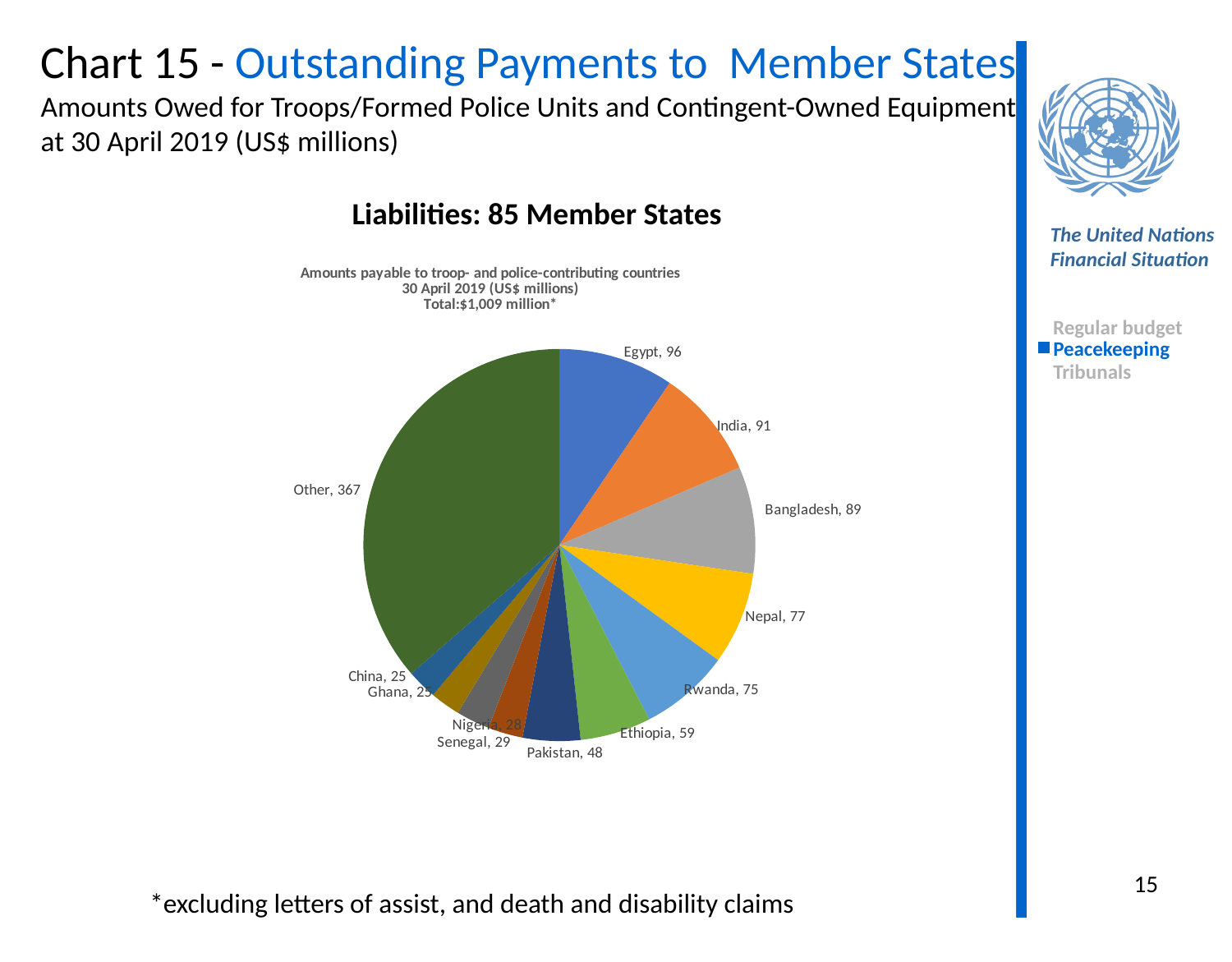
Which slice of the pie chart is the largest? Other What is the value for Senegal in the pie chart? 29 Which is larger, the value for Nepal or the value for Ethiopia? Nepal Which named country has the highest amount payable in the pie chart? Egypt What is the value for Bangladesh in the pie chart? 89 What is the difference between the values for Other and Ethiopia? 308 What is the value for Egypt in the pie chart? 96 What type of chart is shown on the slide? pie chart What total amount is stated in the pie chart's title? $1,009 million What is the difference between the values for Egypt and India? 5 How many slices does the pie chart have? 12 What is the value for Pakistan in the pie chart? 48